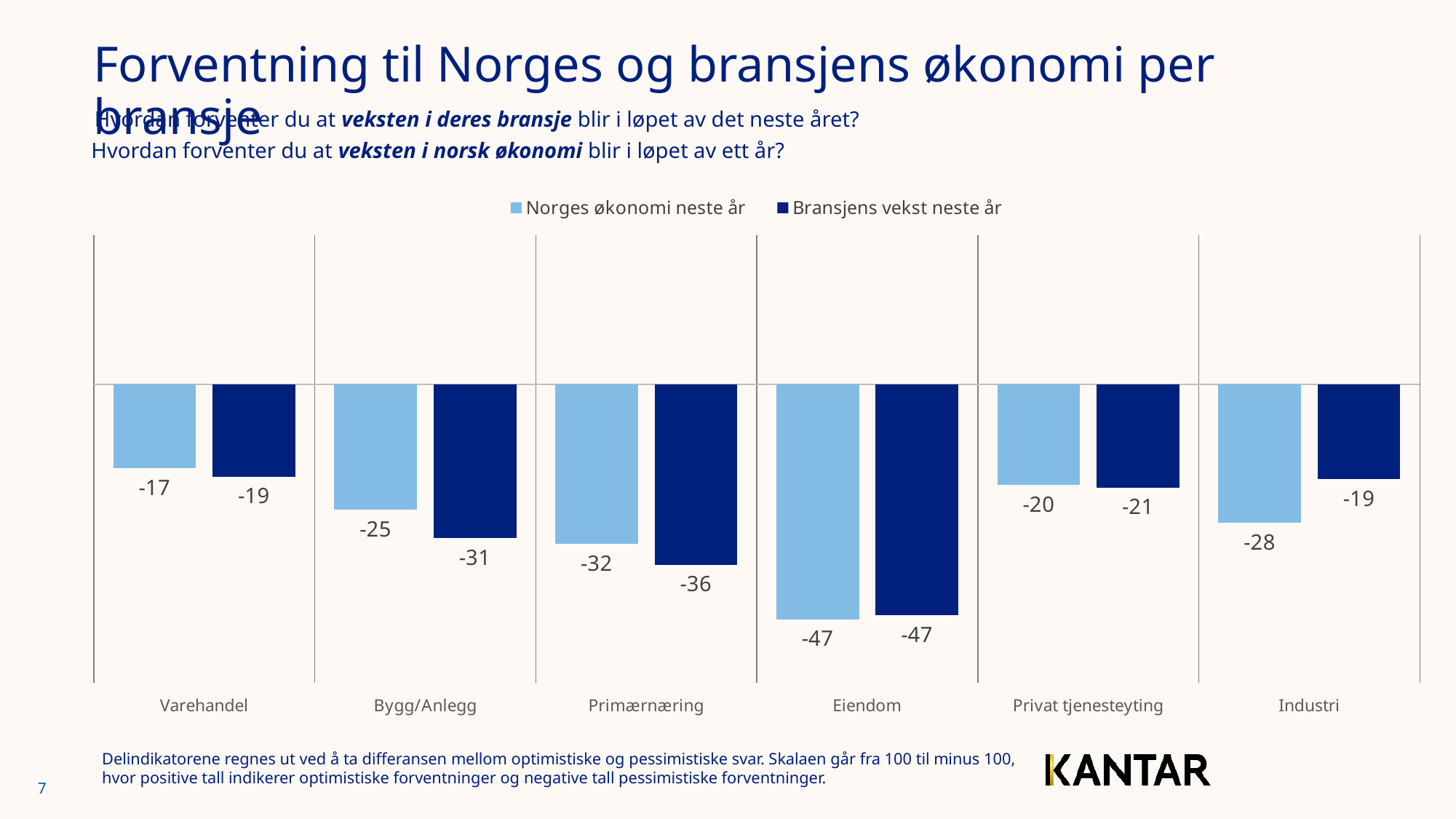
What is the value for Privat tjenesteyting in the 'Bransjens vekst neste år' series? -21 How many categories are shown on the x axis of the chart? 6 What is the value for Varehandel in the 'Norges økonomi neste år' series? -17 What kind of chart is shown on the slide? Bar chart What is the difference between the 'Norges økonomi neste år' and 'Bransjens vekst neste år' values for Industri? 9 What is the value for Industri in the 'Norges økonomi neste år' series? -28 How many series does the legend list? 2 Which category has the lowest value in the 'Norges økonomi neste år' series? Eiendom Which category has the lowest value in the 'Bransjens vekst neste år' series? Eiendom For Primærnæring, which series has the larger value: 'Norges økonomi neste år' or 'Bransjens vekst neste år'? Norges økonomi neste år Which category has the highest value in the 'Norges økonomi neste år' series? Varehandel What is the value for Primærnæring in the 'Bransjens vekst neste år' series? -36